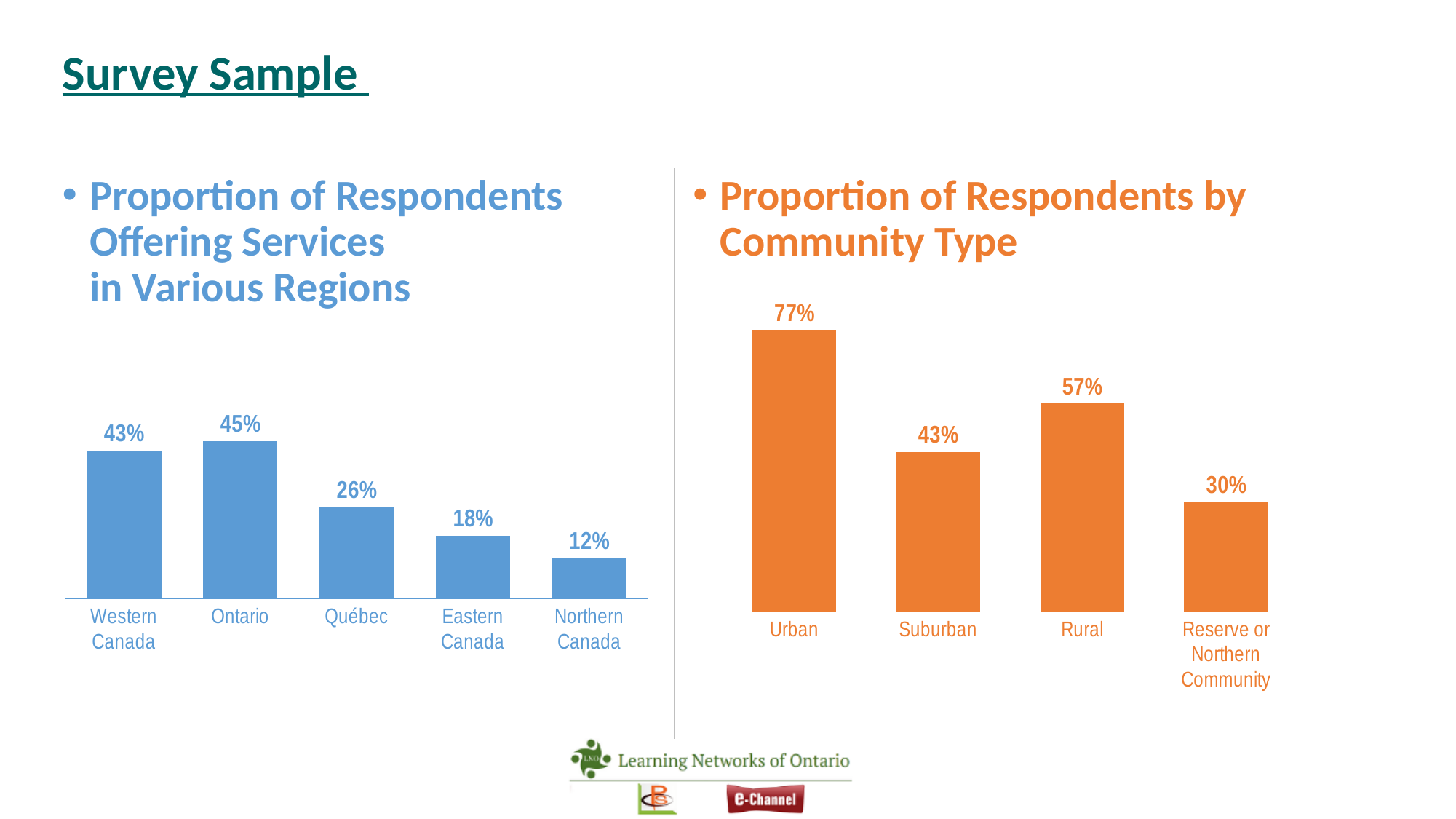
In the right chart (Proportion of Respondents by Community Type), which is larger, Suburban or Rural? Rural What kind of chart is the right chart (Proportion of Respondents by Community Type)? Bar chart In the right chart (Proportion of Respondents by Community Type), which community type has the highest value? Urban In the left chart (Proportion of Respondents Offering Services in Various Regions), what is the difference between Québec and Northern Canada? 14% In the left chart (Proportion of Respondents Offering Services in Various Regions), what is the value for Ontario? 45% In the right chart (Proportion of Respondents by Community Type), what is the value for Rural? 57% In the left chart (Proportion of Respondents Offering Services in Various Regions), what is the value for Eastern Canada? 18% In the right chart (Proportion of Respondents by Community Type), what is the value for Reserve or Northern Community? 30% In the left chart (Proportion of Respondents Offering Services in Various Regions), how many regions are shown? 5 In the right chart (Proportion of Respondents by Community Type), what is the difference between Urban and Suburban? 34% In the left chart (Proportion of Respondents Offering Services in Various Regions), which region has the highest value? Ontario In the left chart (Proportion of Respondents Offering Services in Various Regions), which region has the lowest value? Northern Canada